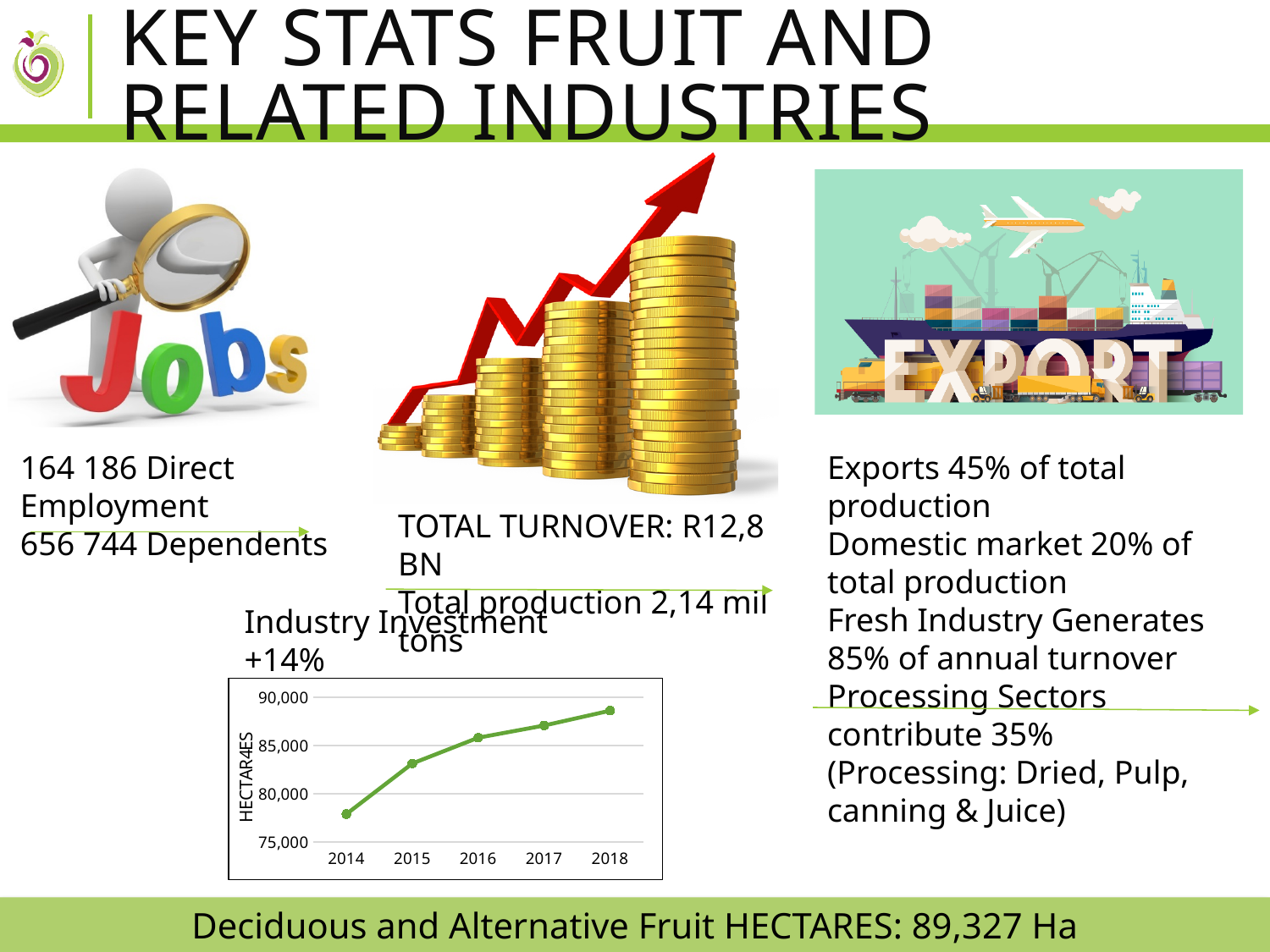
Is the value for 2017 in the line chart greater or less than 85,000? greater Is the value for 2015 in the line chart greater or less than 80,000? greater Which year has the lowest value in the line chart? 2014 What kind of chart is shown on the slide? line chart In the line chart, which year has the larger value, 2014 or 2018? 2018 What is the label on the y axis of the line chart? HECTAR4ES Do the values in the line chart rise or fall from 2014 to 2018? rise What is the first year shown on the x axis of the line chart? 2014 Is the value for 2014 in the line chart greater or less than 80,000? less Which year has the highest value in the line chart? 2018 How many years are plotted on the x axis of the line chart? 5